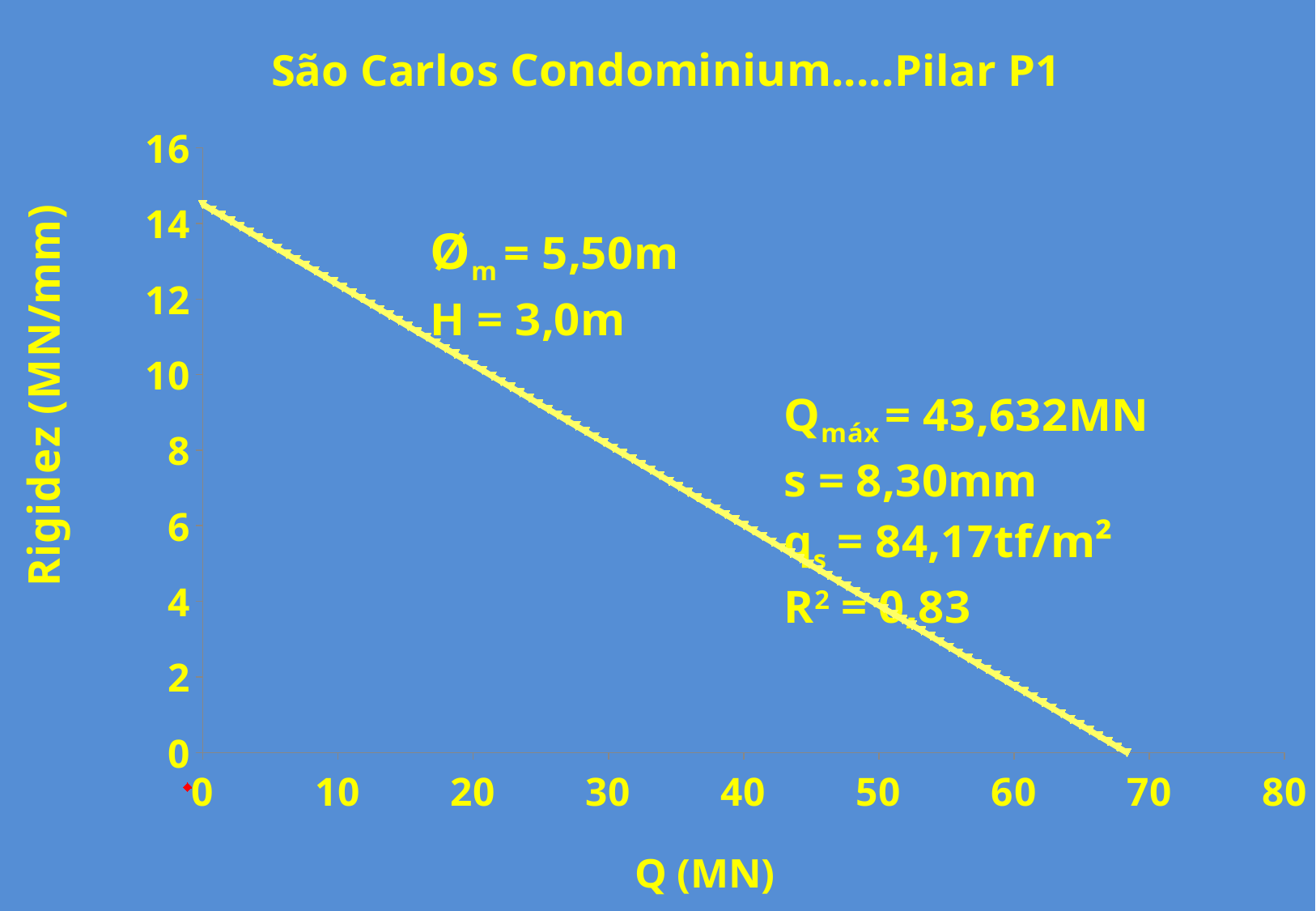
What is the title of the chart? São Carlos Condominium.....Pilar P1 Is the Rigidez value at Q = 60 MN greater or less than 4? less Does the Rigidez value rise or fall as Q increases along the x axis? fall What is the label of the y axis? Rigidez (MN/mm) Which has the higher Rigidez value, Q = 10 MN or Q = 50 MN? Q = 10 MN At which end of the x axis is the Rigidez value highest, Q = 0 MN or Q = 70 MN? Q = 0 MN Is the Rigidez value at Q = 10 MN greater or less than 10? greater What kind of chart is shown on the slide? line chart Is the Rigidez value at Q = 0 MN greater or less than 12? greater